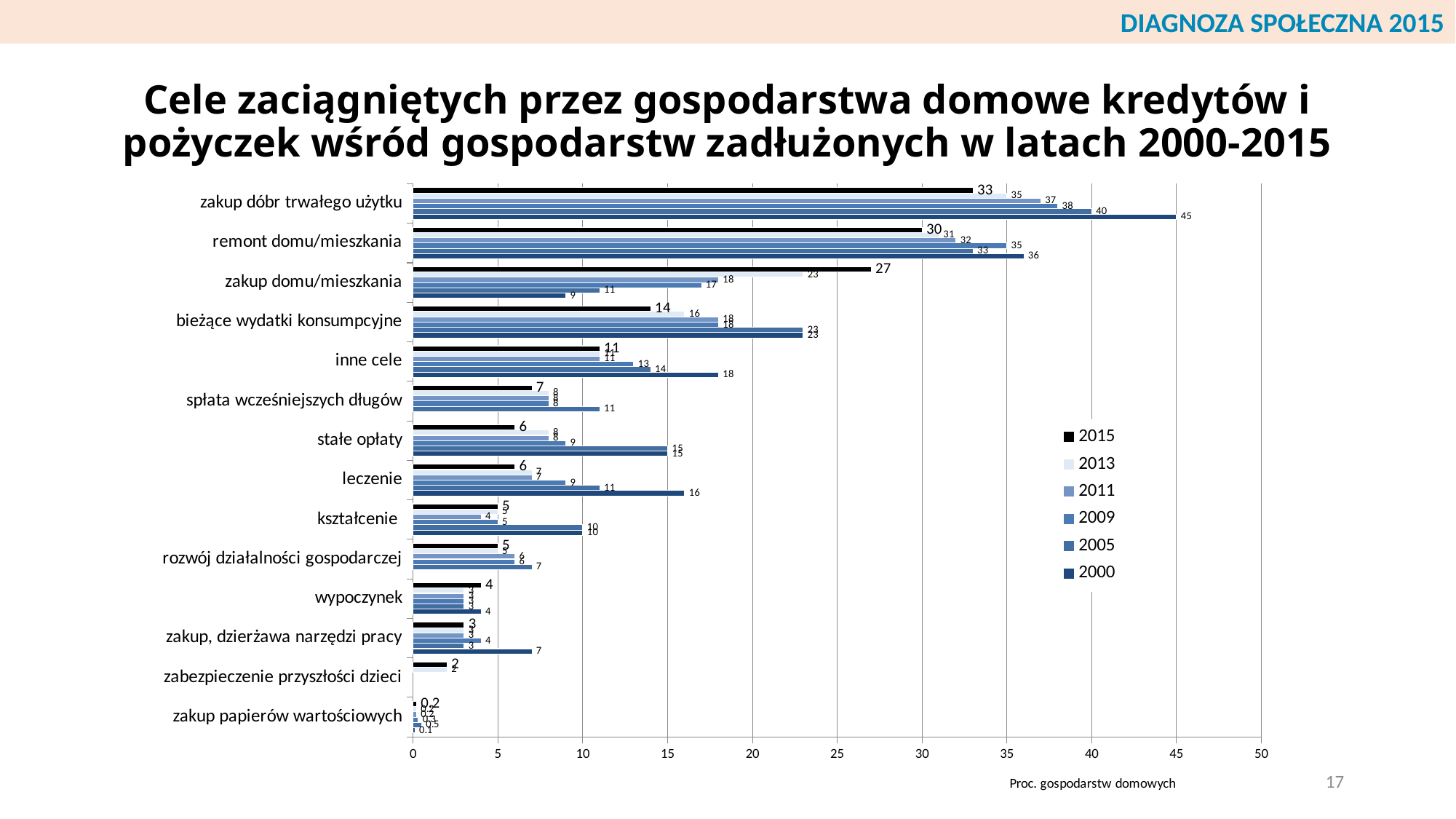
How many categories are shown on the chart? 14 For "zakup domu/mieszkania", which is larger: the 2015 value or the 2000 value? 2015 Which category has the lowest 2015 value? zakup papierów wartościowych Which category has the highest 2015 value? zakup dóbr trwałego użytku What kind of chart is shown on the slide? bar chart What is the 2015 value for "zakup dóbr trwałego użytku"? 33 What is the label of the horizontal axis? Proc. gospodarstw domowych What is the 2015 value for "remont domu/mieszkania"? 30 What is the 2015 value for "zakup domu/mieszkania"? 27 How many series does the legend list? 6 What is the difference between the 2000 and 2015 values for "zakup dóbr trwałego użytku"? 12 What is the 2000 value for "zakup dóbr trwałego użytku"? 45